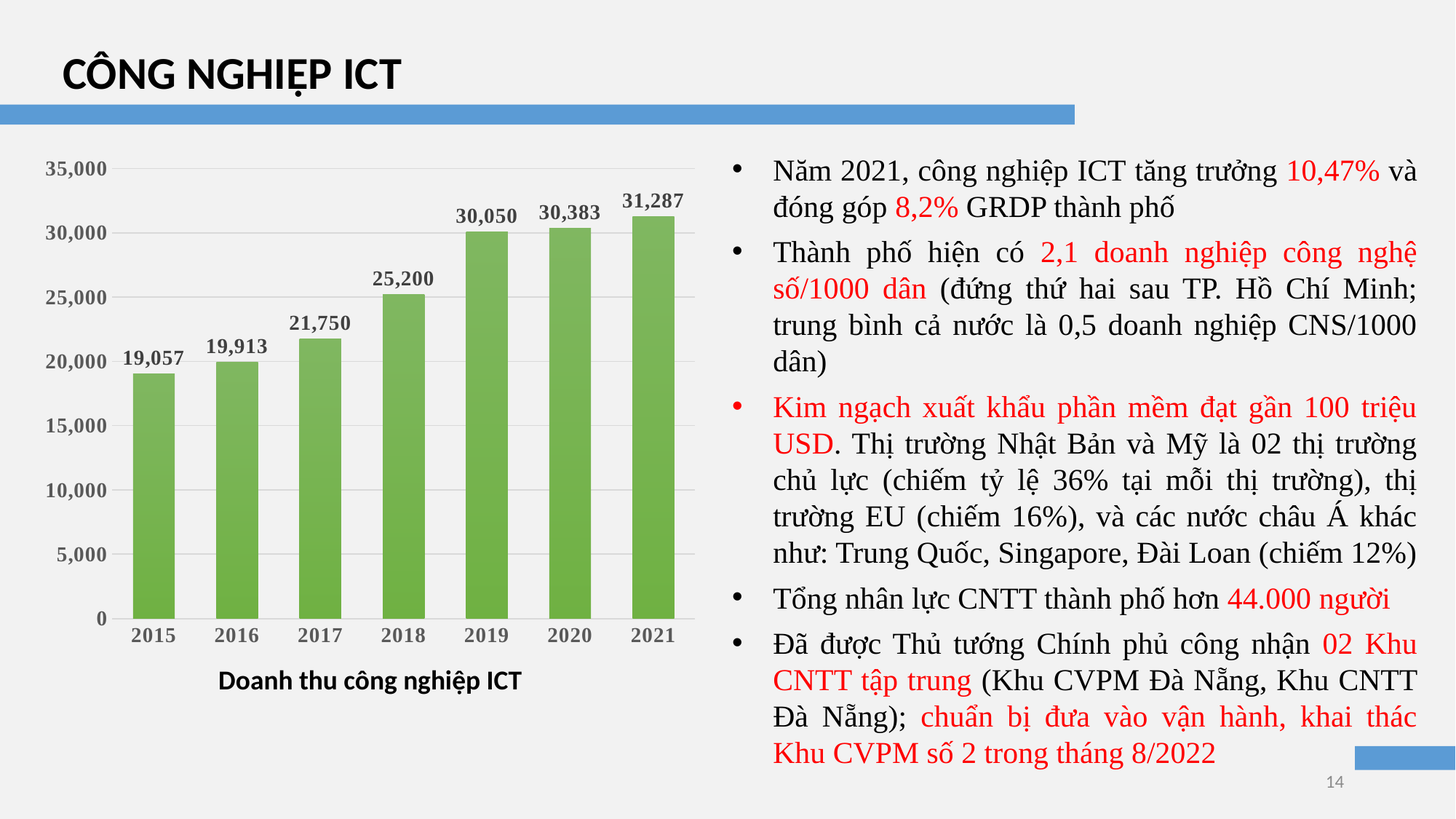
Which year has the highest value in the chart? 2021 How many years are shown in the chart? 7 Do the values rise or fall from 2015 to 2021? rise Which is larger, the value for 2019 or the value for 2017? 2019 Which year has the lowest value in the chart? 2015 What is the difference between the values for 2021 and 2015? 12,230 Is the value for 2016 greater or less than 20,000? less What is the difference between the values for 2018 and 2017? 3,450 What is the value for 2021 in the chart? 31,287 What is the value for 2015 in the chart? 19,057 What kind of chart is shown on the slide? bar chart What is the value for 2018 in the chart? 25,200